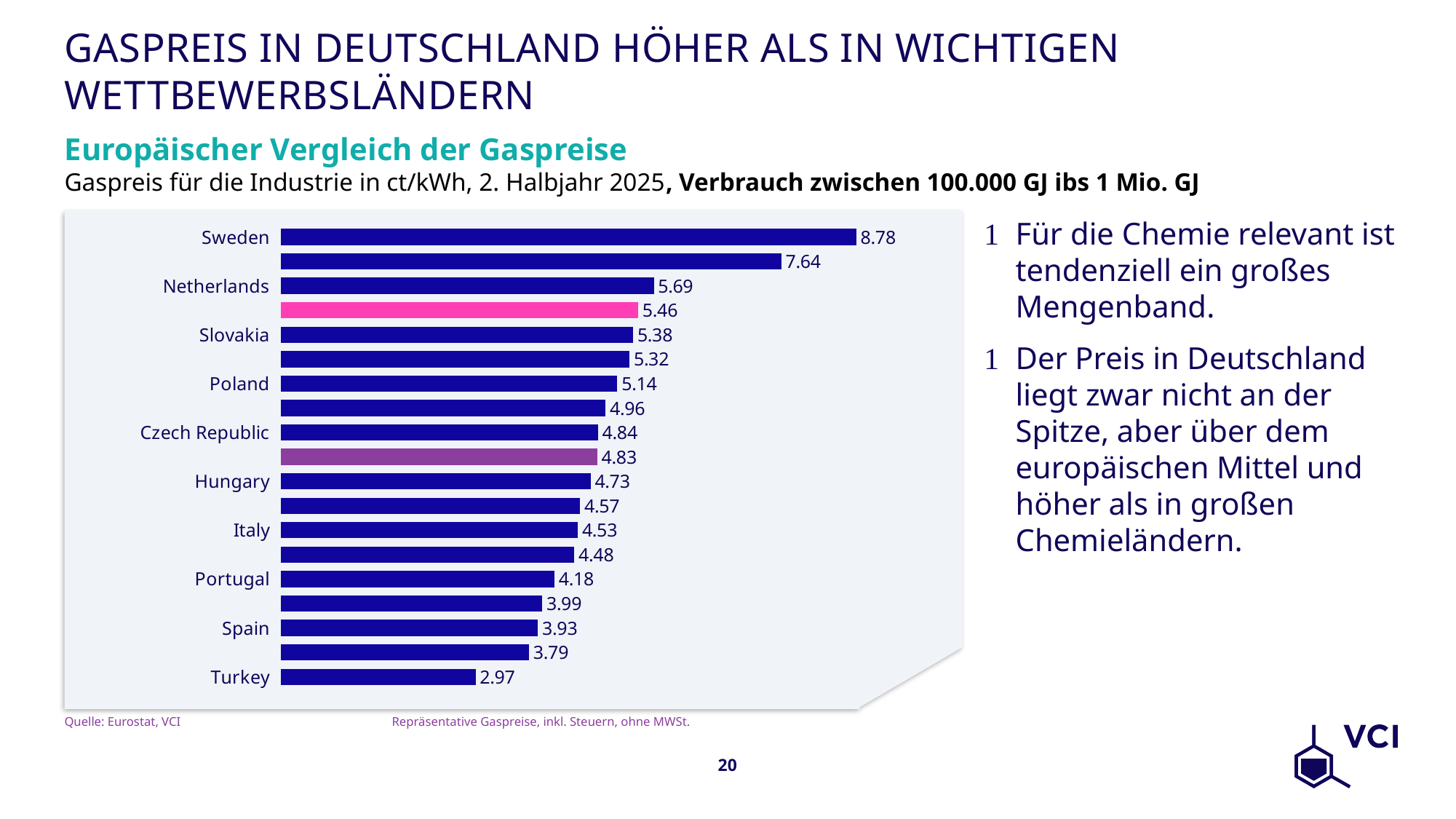
What is the gas price shown for Sweden? 8.78 Which country has the highest gas price in the chart? Sweden How many bars are plotted in the chart? 19 What is the gas price shown for the Netherlands? 5.69 Which country has the lowest gas price in the chart? Turkey What is the gas price shown for Turkey? 2.97 What is the difference between the gas prices of Sweden and Turkey? 5.81 What is the gas price shown for Poland? 5.14 What value is shown on the pink highlighted bar? 5.46 What is the difference between the gas prices of the Netherlands and Slovakia? 0.31 Which has a higher gas price, Hungary or Spain? Hungary What type of chart is shown on the slide? Bar chart